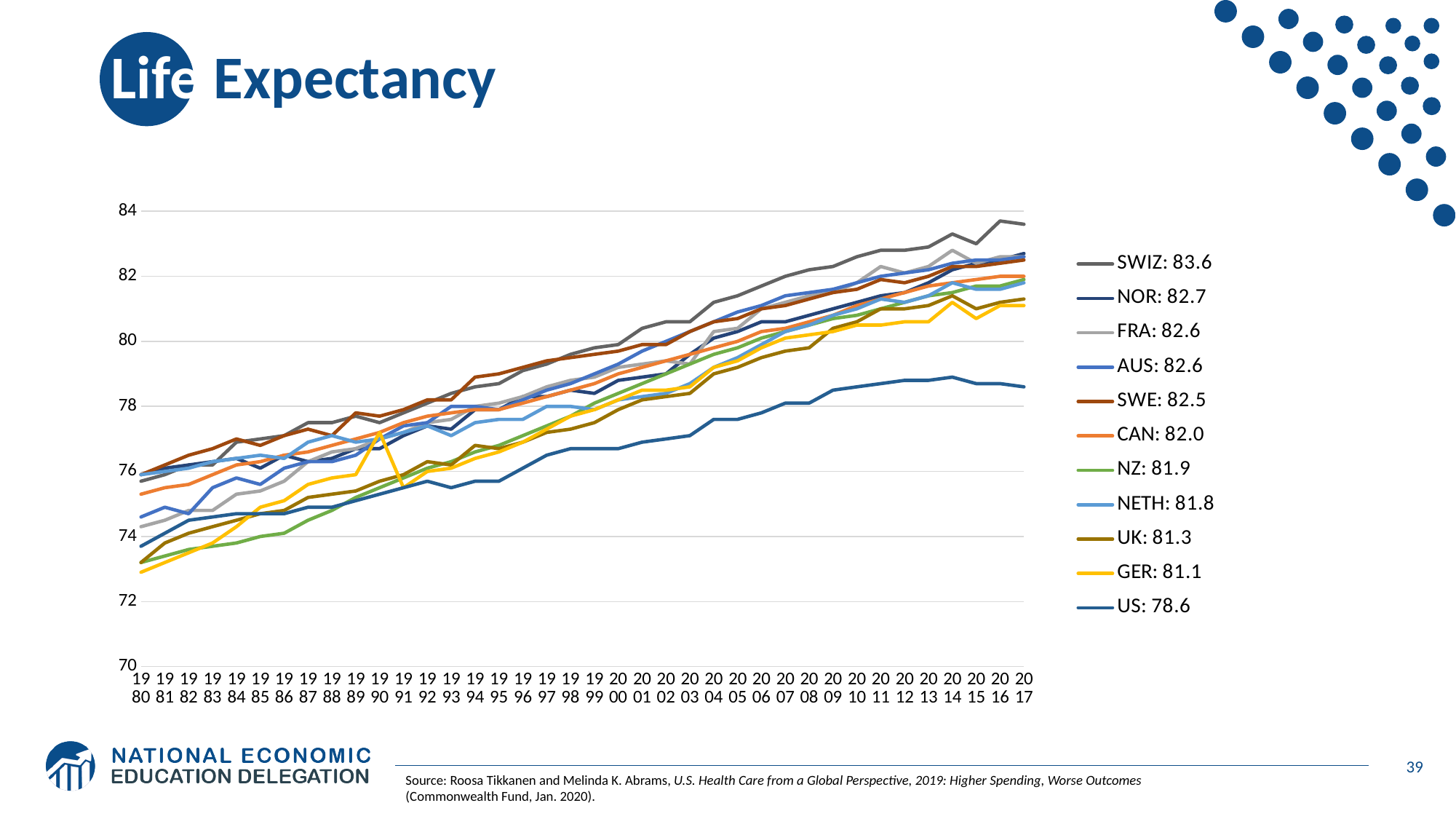
Is the value for US in 2017 greater or less than 80? less What is the first year shown on the x axis? 1980 According to the legend, what value is shown for UK? 81.3 Which country has the highest value in the legend? SWIZ What is the difference between the legend values for SWIZ and US? 5.0 Which country has the lowest value in the legend? US Which has a larger legend value, CAN or GER? CAN What kind of chart is shown on the slide? line chart According to the legend, what value is shown for US? 78.6 How many series does the legend list? 11 Do the lines generally rise or fall from 1980 to 2017? rise According to the legend, what value is shown for SWIZ? 83.6